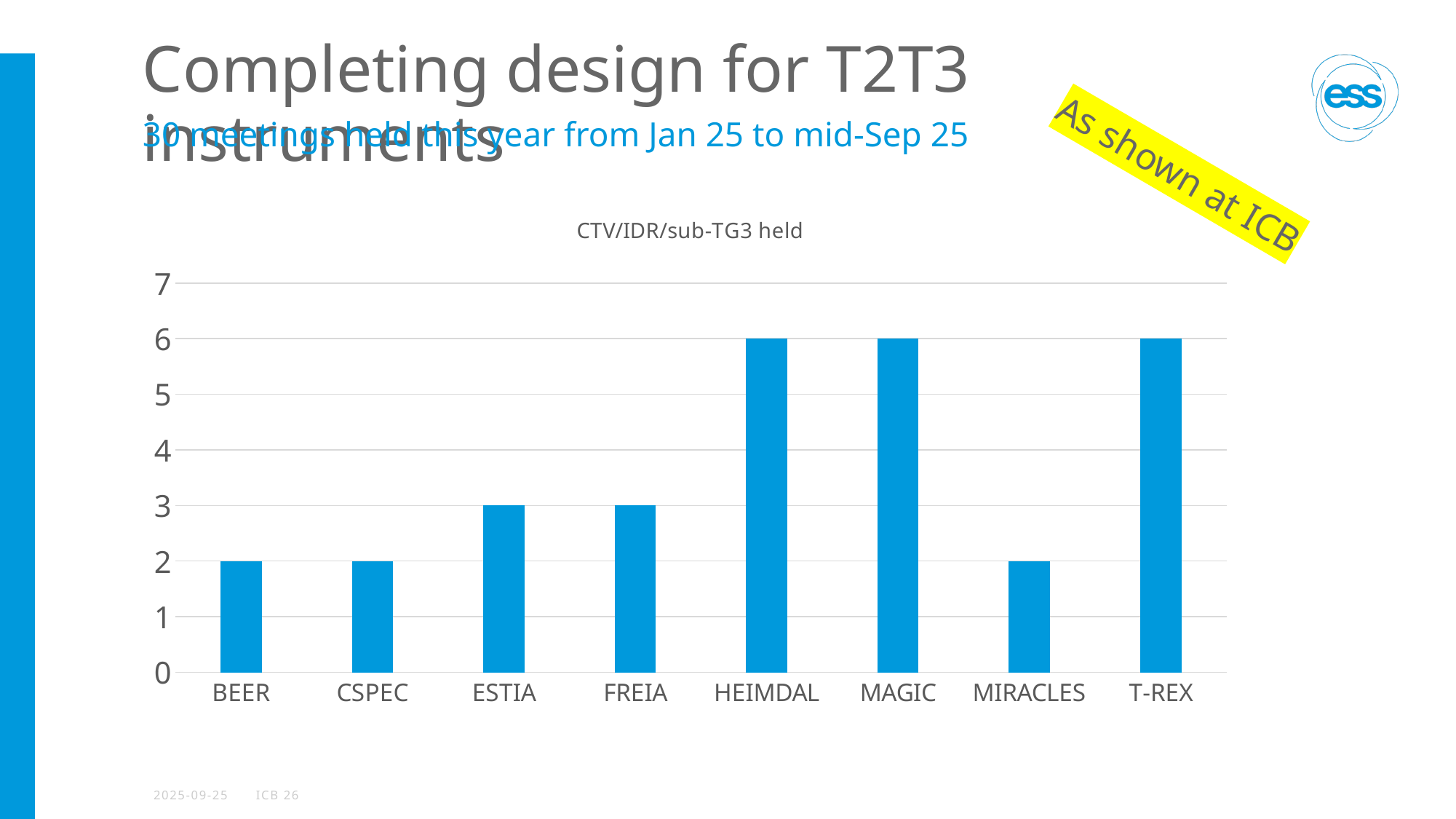
What is the title of the chart? CTV/IDR/sub-TG3 held What is the difference between the values for HEIMDAL and BEER? 4 How many categories are shown on the x axis? 8 What is the value for ESTIA? 3 What is the difference between the values for FREIA and CSPEC? 1 What is the value for T-REX? 6 What is the value for HEIMDAL? 6 What kind of chart is shown on the slide? bar chart Is the value for HEIMDAL greater or less than 5? greater Which is larger, the value for MAGIC or the value for FREIA? MAGIC Which is larger, the value for ESTIA or the value for MIRACLES? ESTIA What is the value for MIRACLES? 2